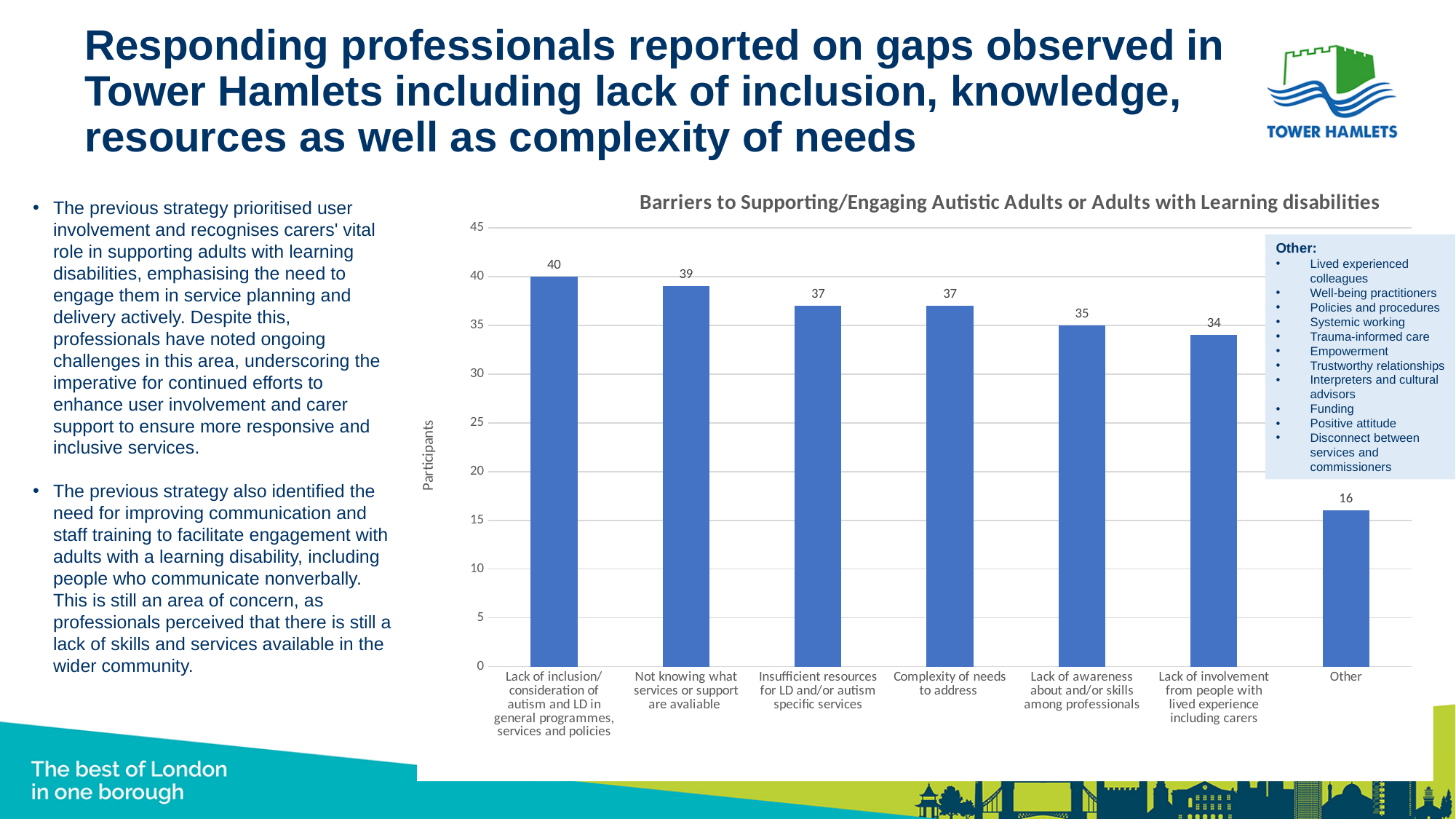
Which category has the lowest value? Other How many participants reported "Other" as a barrier? 16 What is the title of the chart? Barriers to Supporting/Engaging Autistic Adults or Adults with Learning disabilities What kind of chart is this? Bar chart What is the value for "Lack of awareness about and/or skills among professionals"? 35 What is the difference between "Not knowing what services or support are avaliable" and "Lack of involvement from people with lived experience including carers"? 5 Which is larger: "Not knowing what services or support are avaliable" or "Lack of awareness about and/or skills among professionals"? Not knowing what services or support are avaliable How many categories are shown on the x axis? 7 Do the values generally rise or fall from left to right along the x axis? Fall Which category has the highest value? Lack of inclusion/consideration of autism and LD in general programmes, services and policies What is the value for "Complexity of needs to address"? 37 What is the difference between "Lack of inclusion/consideration of autism and LD in general programmes, services and policies" and "Other"? 24